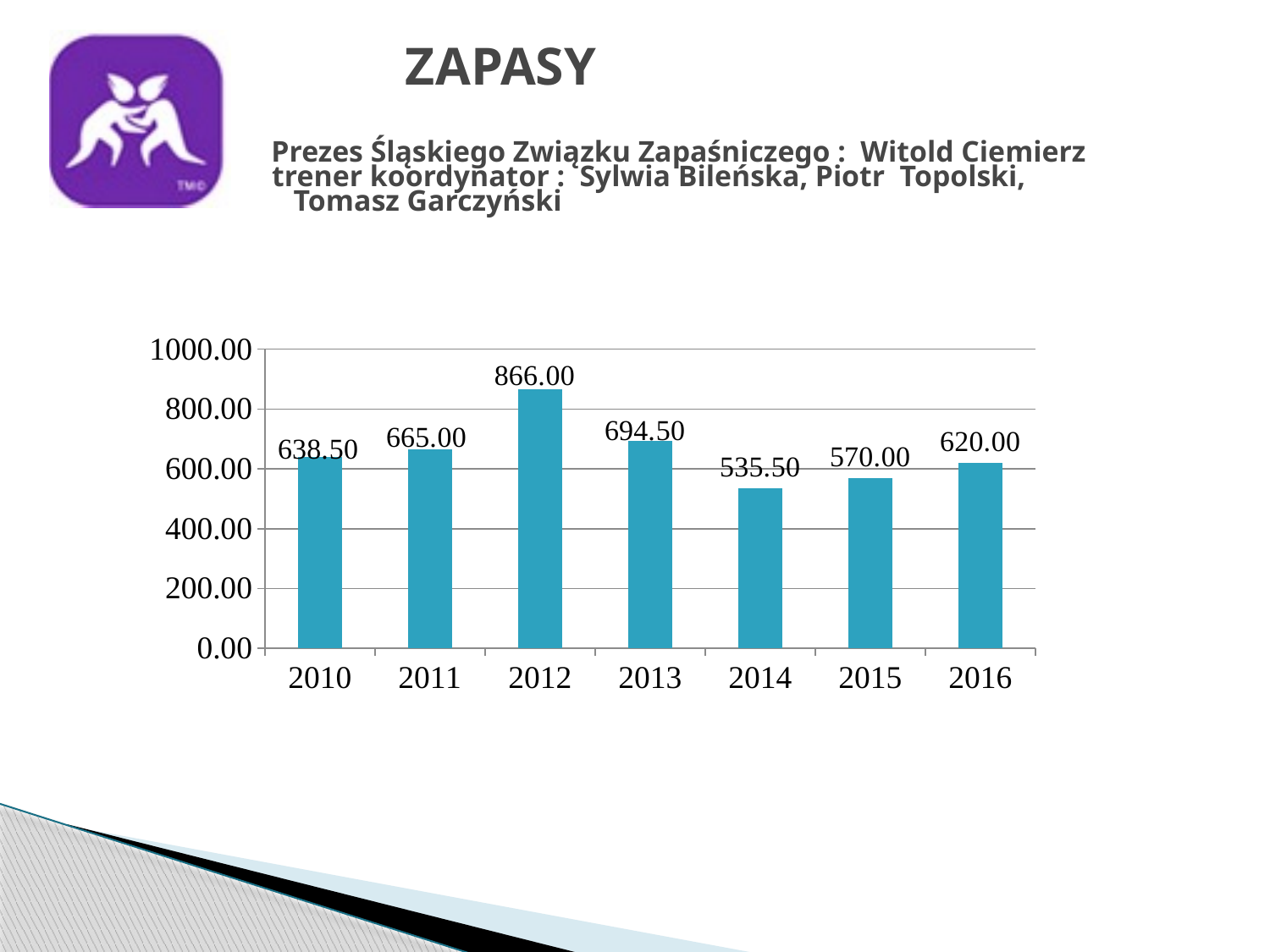
What is the value for 2014? 535.50 Which is larger, the value for 2011 or the value for 2016? 2011 Do the values rise or fall from 2013 to 2014? fall What is the value for 2012? 866.00 What is the value for 2010? 638.50 What kind of chart is shown on the slide? bar chart What is the difference between the values for 2012 and 2013? 171.50 What is the difference between the values for 2016 and 2015? 50.00 Which year has the highest value? 2012 Is the value for 2013 greater or less than 600.00? greater Which year has the lowest value? 2014 How many years are shown on the x axis? 7